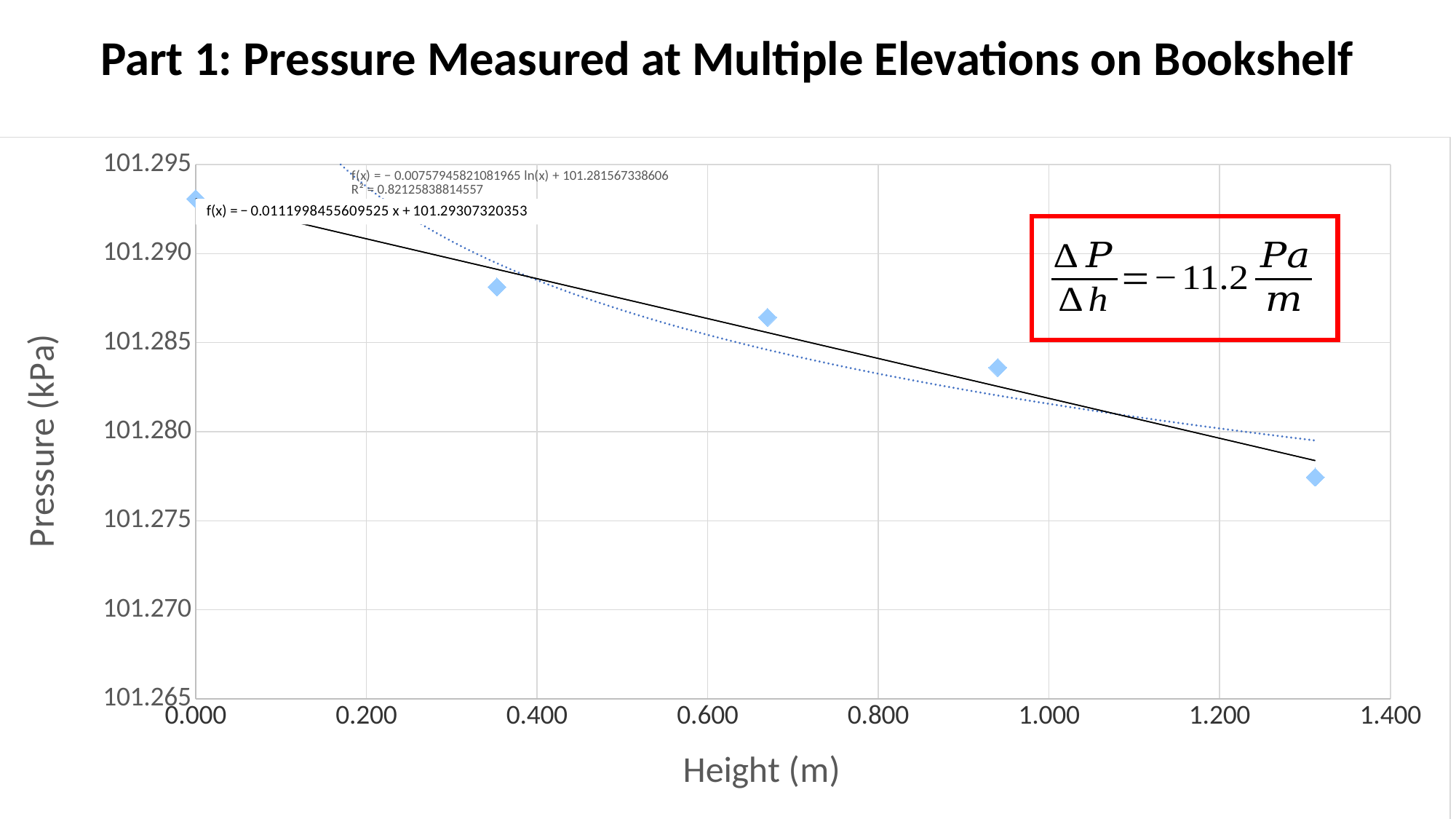
Is the pressure value for the data point at a height of 0.000 m greater or less than 101.290 kPa? greater Which data point has the higher pressure: the one at the lowest height or the one at the highest height? the one at the lowest height How many data points are plotted on the chart? 5 Is the pressure value for the data point at roughly 0.94 m height greater or less than 101.285 kPa? less What is the title of the chart on the slide? Part 1: Pressure Measured at Multiple Elevations on Bookshelf Is the pressure value for the data point at roughly 0.35 m height greater or less than 101.285 kPa? greater What is the highest value shown on the y axis? 101.295 What kind of chart is shown on the slide? scatter plot Do the pressure values rise or fall as height increases along the x axis? fall What is the slope of the linear fit line, as given in the f(x) equation on the chart? -0.0111998455609525 What R² value is printed on the chart for the logarithmic fit? 0.82125838814557